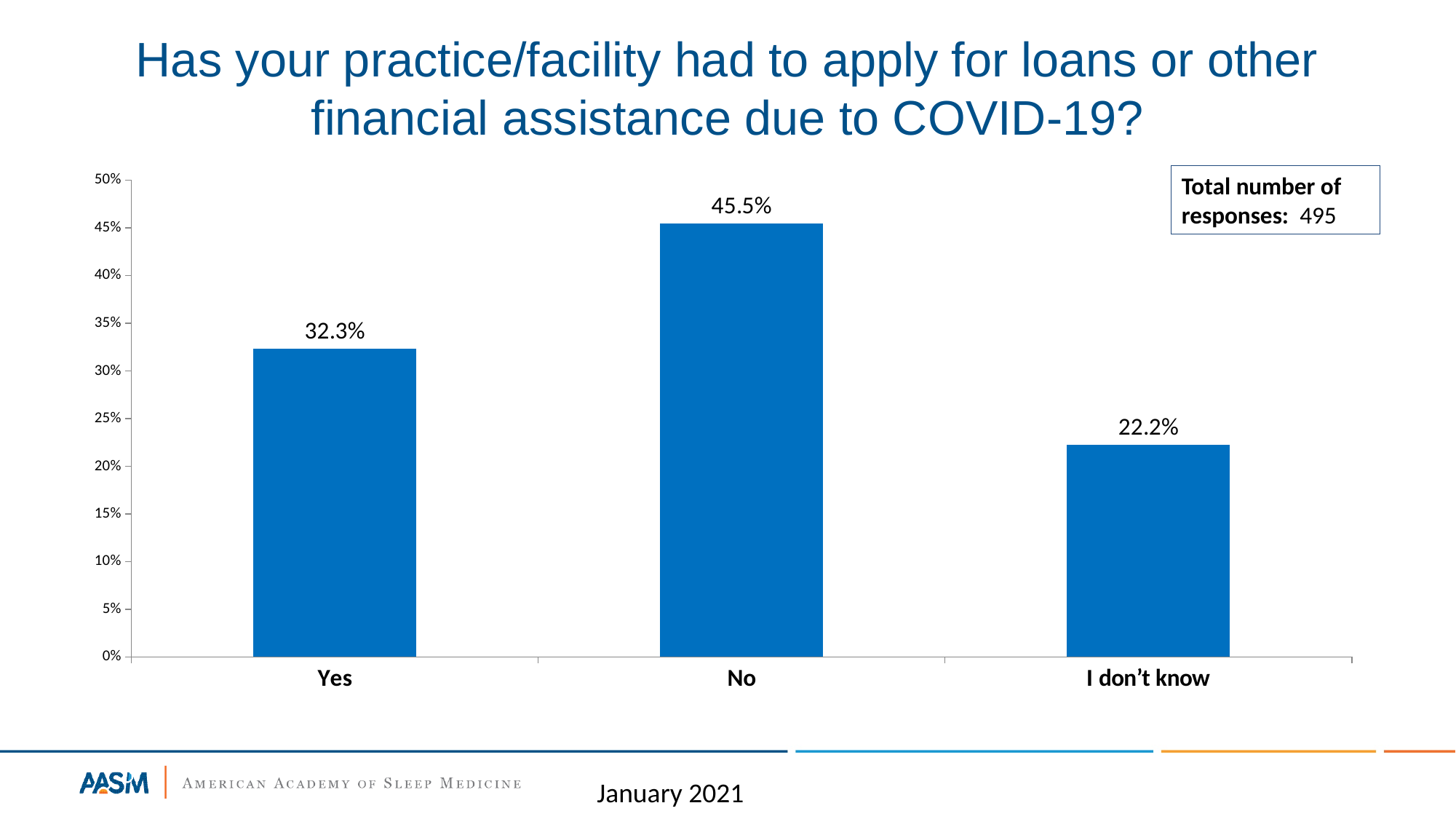
What type of chart is shown on the slide? Bar chart What percentage of respondents answered "No"? 45.5% How many response categories are shown on the x axis? 3 What is the total number of responses stated on the slide? 495 Which response category has the highest percentage? No Is the value for "No" greater or less than 40%? greater What is the difference in percentage points between the "No" and "Yes" responses? 13.2 percentage points What percentage of respondents answered "Yes"? 32.3% What percentage of respondents answered "I don't know"? 22.2% What is the difference in percentage points between the "Yes" and "I don't know" responses? 10.1 percentage points Which response category has the lowest percentage? I don't know Which is larger, the percentage for "Yes" or for "I don't know"? Yes